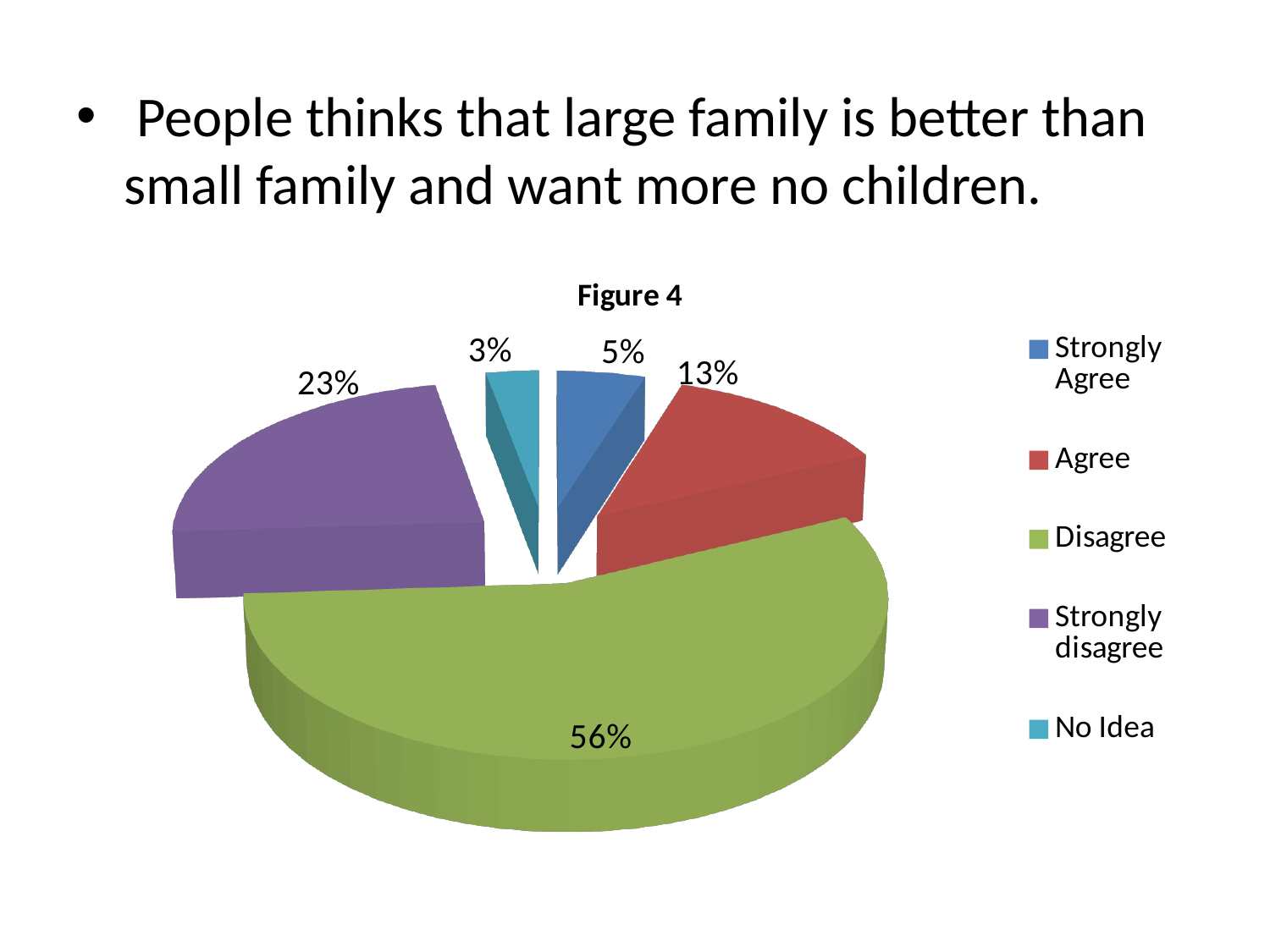
Which is larger, the share for Agree or the share for Strongly Agree? Agree What kind of chart is shown on the slide? pie chart What is the difference in percentage points between Disagree and Strongly disagree? 33 What percentage of the pie is labelled Agree? 13% What percentage of the pie is labelled Strongly disagree? 23% How many categories does the legend list? 5 What percentage of the pie is labelled No Idea? 3% Which category has the largest share of the pie? Disagree What percentage of the pie is labelled Disagree? 56% What is the chart's title? Figure 4 What percentage of the pie is labelled Strongly Agree? 5% Which category has the smallest share of the pie? No Idea